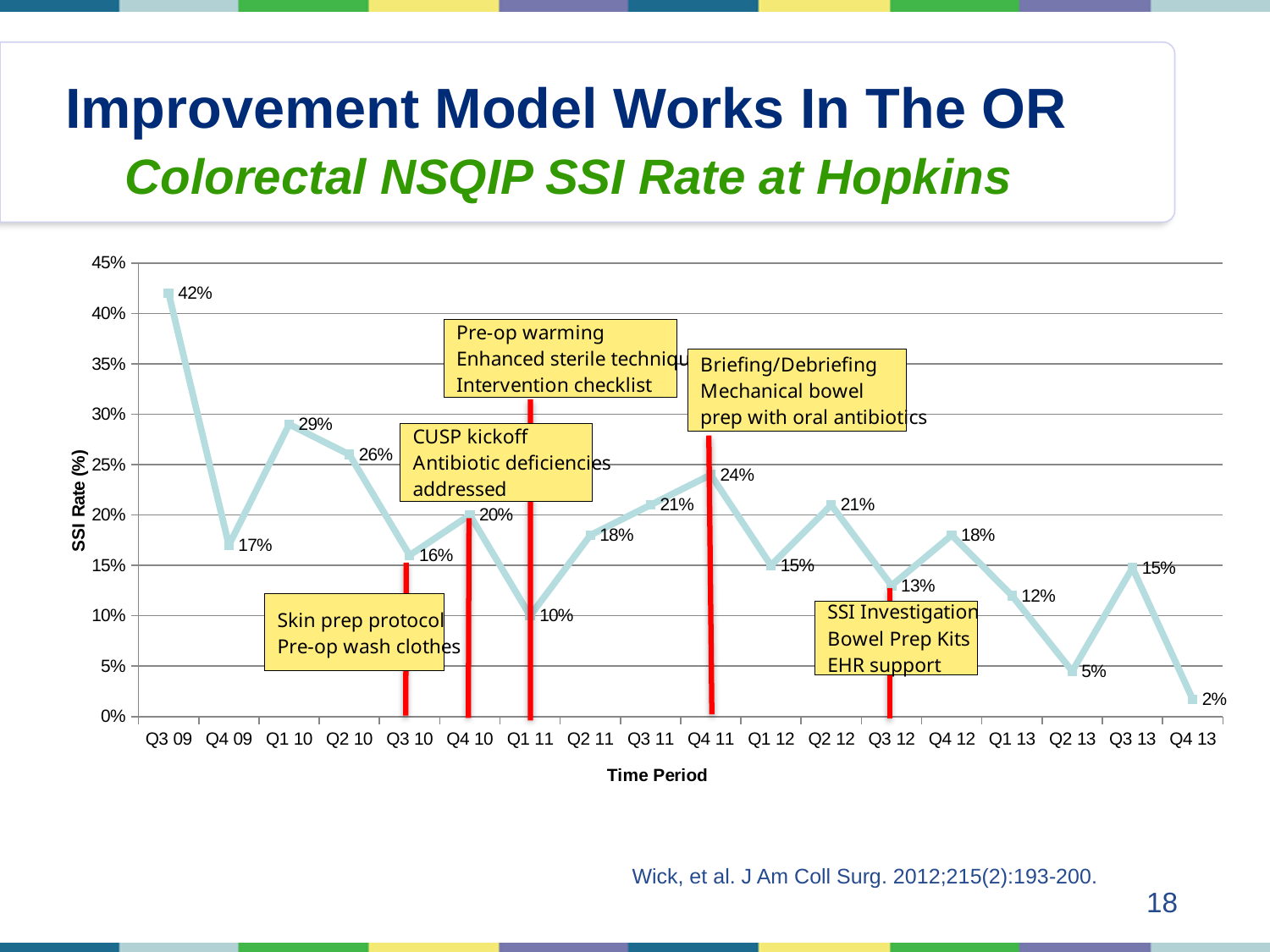
What is the SSI rate for Q4 13? 2% Which has a higher SSI rate, Q1 10 or Q2 10? Q1 10 Is the SSI rate for Q2 13 greater or less than 10%? less What is the SSI rate for Q1 11? 10% What is the SSI rate for Q3 09? 42% Which time period has the lowest SSI rate? Q4 13 What is the SSI rate for Q4 11? 24% What type of chart is shown on the slide? Line chart How many time periods are plotted on the chart? 18 Which time period has the highest SSI rate? Q3 09 What is the label of the y axis? SSI Rate (%) What is the difference between the SSI rate in Q3 09 and Q4 09? 25%